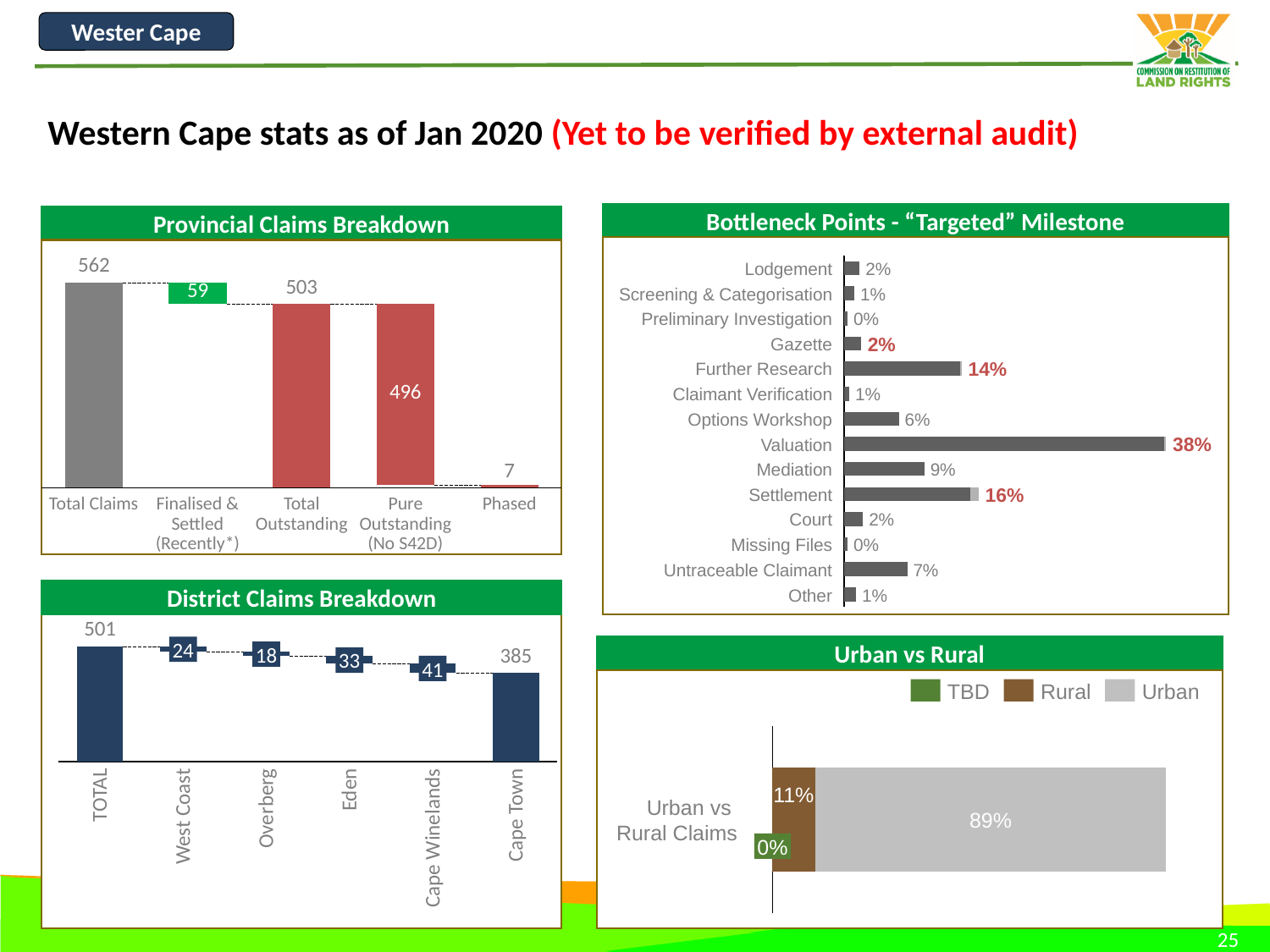
In the Bottleneck Points chart, which category has the highest percentage? Valuation In the District Claims Breakdown chart, which district (excluding TOTAL) has the lowest value? Overberg In the Urban vs Rural chart, what is the value for Urban? 89% How many series does the legend of the Urban vs Rural chart list? 3 In the Bottleneck Points chart, what is the difference between Settlement and Mediation? 7% In the District Claims Breakdown chart, which is larger, Eden or Cape Winelands? Cape Winelands In the Provincial Claims Breakdown chart, what is the difference between Total Claims and Total Outstanding? 59 In the Provincial Claims Breakdown chart, what is the value for Pure Outstanding (No S42D)? 496 How many categories are shown in the Bottleneck Points chart? 14 In the Provincial Claims Breakdown chart, what is the value for Total Claims? 562 In the Bottleneck Points chart, what is the value for Further Research? 14% In the District Claims Breakdown chart, what is the value for Cape Town? 385